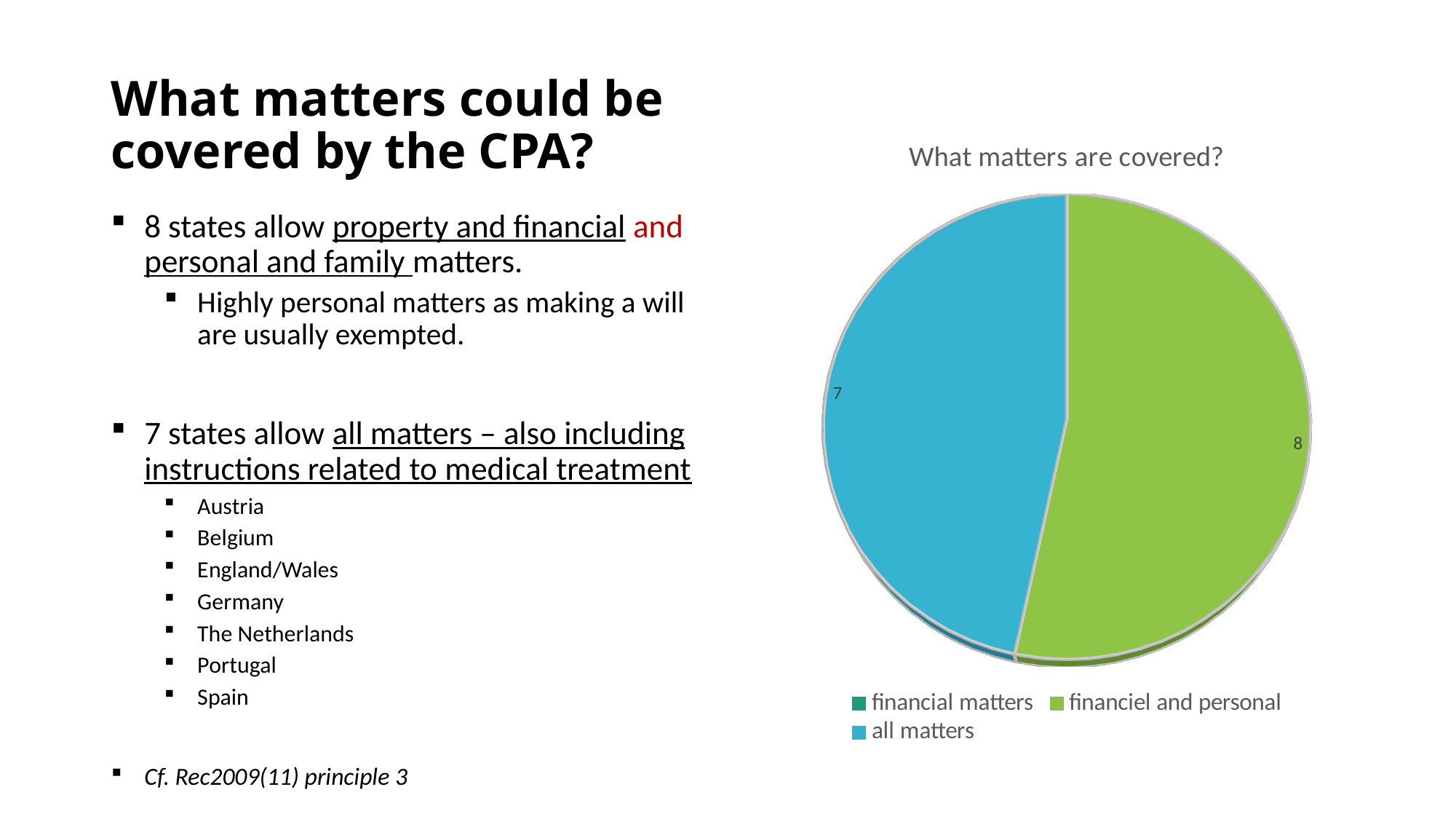
What type of chart is shown on the slide? pie chart Which slice of the pie chart has the largest value? financiel and personal What is the title of the chart? What matters are covered? What colour is the 'all matters' slice in the pie chart? blue What value is shown for the 'all matters' slice of the pie chart? 7 What value is shown for the 'financiel and personal' slice of the pie chart? 8 How many slices in the pie chart have a data label? 2 What is the difference between the 'financiel and personal' value and the 'all matters' value? 1 How many entries does the chart legend list? 3 Which of the two labelled slices, 'financiel and personal' or 'all matters', is larger? financiel and personal